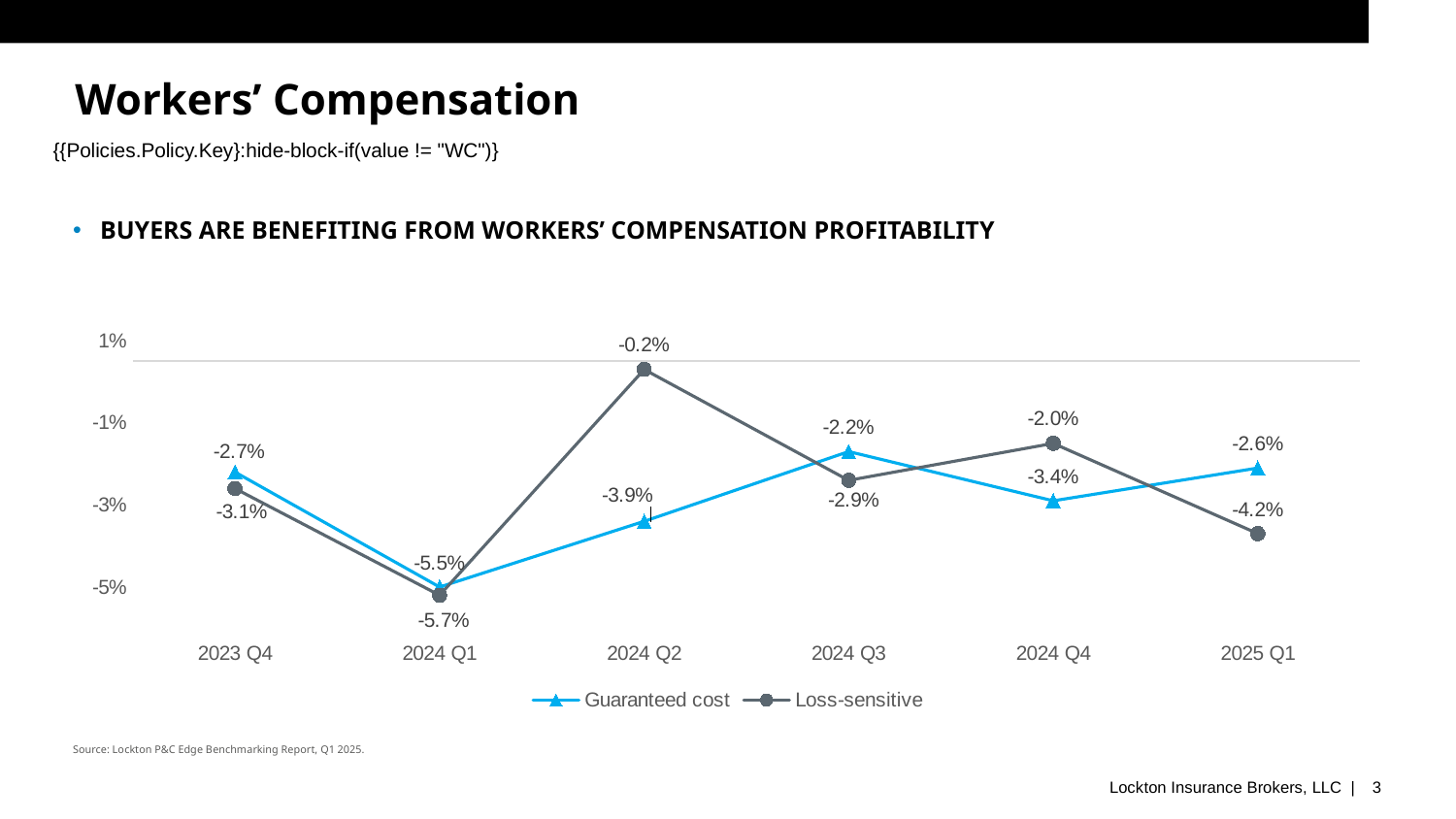
Which series has the higher value in 2024 Q4, Guaranteed cost or Loss-sensitive? Loss-sensitive What is the difference between the Loss-sensitive and Guaranteed cost values in 2025 Q1? 1.6% What kind of chart is shown on the slide? Line chart How many series does the chart legend list? 2 How many quarters are plotted along the x axis? 6 In which quarter is the Loss-sensitive series at its lowest value? 2024 Q1 What is the Loss-sensitive value for 2024 Q4? -2.0% What is the Guaranteed cost value for 2025 Q1? -2.6% What is the Guaranteed cost value for 2024 Q1? -5.5% In which quarter is the Guaranteed cost series at its highest value? 2024 Q3 What is the Loss-sensitive value for 2024 Q2? -0.2% Which series is drawn with triangle markers? Guaranteed cost